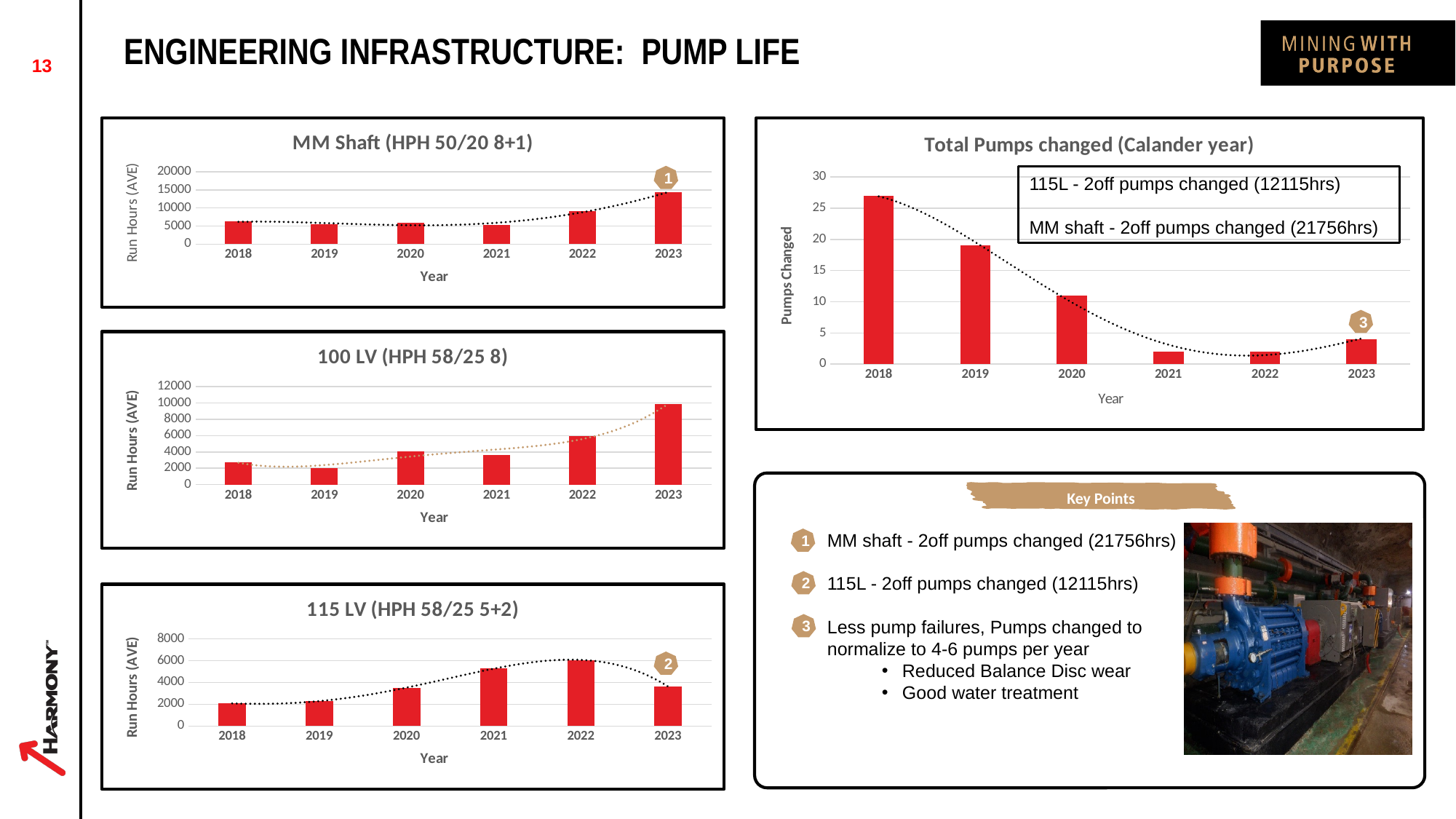
What kind of chart is the 'Total Pumps changed (Calander year)' chart? bar chart In the 'Total Pumps changed (Calander year)' chart, do the values generally rise or fall from 2018 to 2022? fall In the 'Total Pumps changed (Calander year)' chart, which year has the highest number of pumps changed? 2018 In the '100 LV (HPH 58/25 8)' chart, which year has the lowest run hours? 2019 In the '100 LV (HPH 58/25 8)' chart, is the value for 2023 greater or less than 8000? greater In the 'MM Shaft (HPH 50/20 8+1)' chart, which year has the highest run hours? 2023 How many years are shown on the x axis of the '115 LV (HPH 58/25 5+2)' chart? 6 In the 'Total Pumps changed (Calander year)' chart, is the value for 2023 greater or less than 5? less In the 'Total Pumps changed (Calander year)' chart, is the value for 2018 greater or less than 25? greater In the 'Total Pumps changed (Calander year)' chart, which is larger, the value for 2019 or the value for 2020? 2019 In the '115 LV (HPH 58/25 5+2)' chart, which year has the highest run hours? 2022